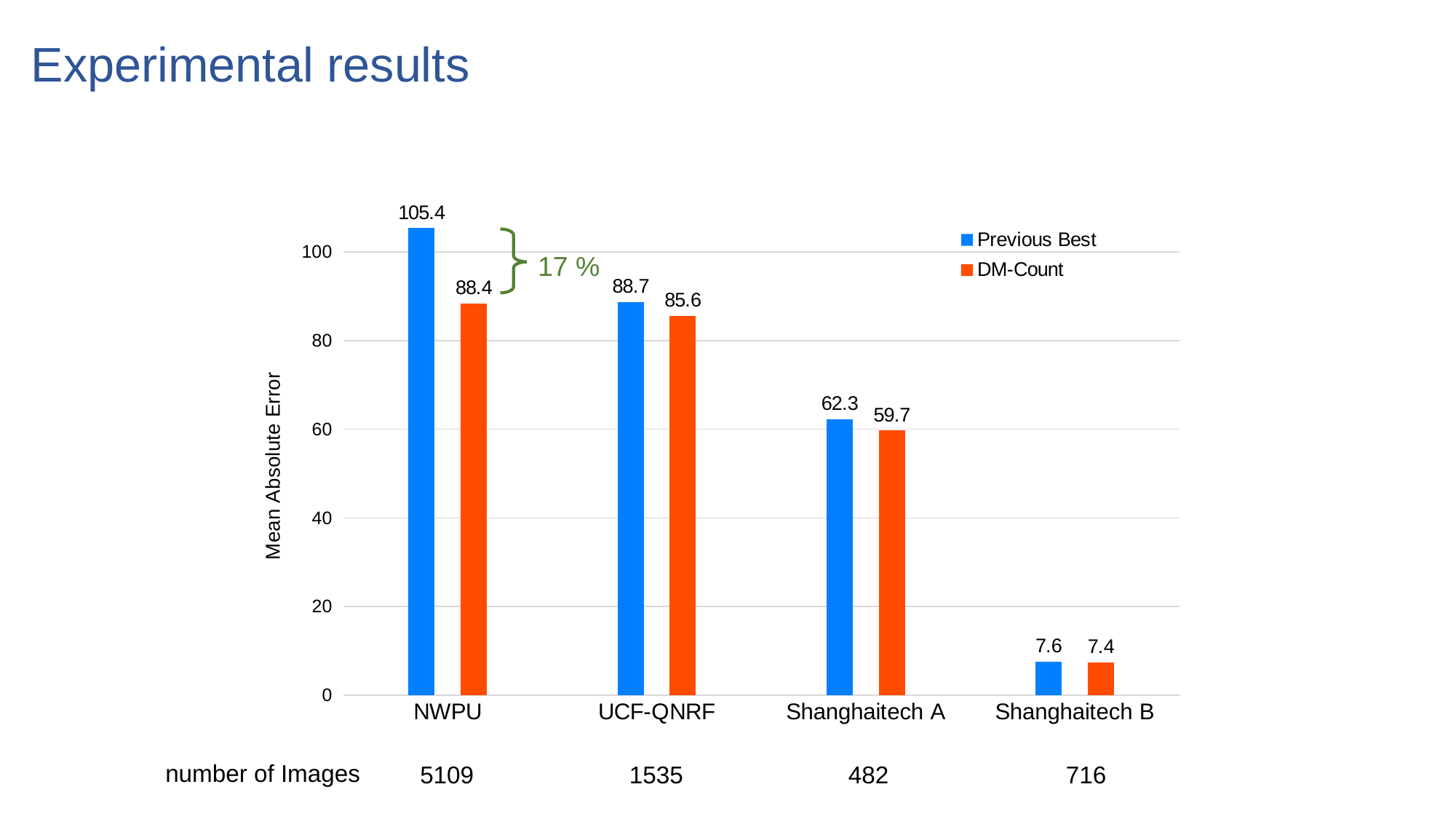
On UCF-QNRF, which has the larger Mean Absolute Error, Previous Best or DM-Count? Previous Best Which dataset has the highest Mean Absolute Error for Previous Best? NWPU What kind of chart is shown on the slide? Bar chart How many series does the legend list? 2 What is the difference between Previous Best and DM-Count on Shanghaitech A? 2.6 What is the Mean Absolute Error of Previous Best on NWPU? 105.4 Which dataset has the lowest Mean Absolute Error for DM-Count? Shanghaitech B What is the Mean Absolute Error of DM-Count on Shanghaitech B? 7.4 What is the difference between Previous Best and DM-Count on NWPU? 17.0 How many datasets are shown on the x axis? 4 What is the Mean Absolute Error of DM-Count on UCF-QNRF? 85.6 What is the label of the y axis? Mean Absolute Error